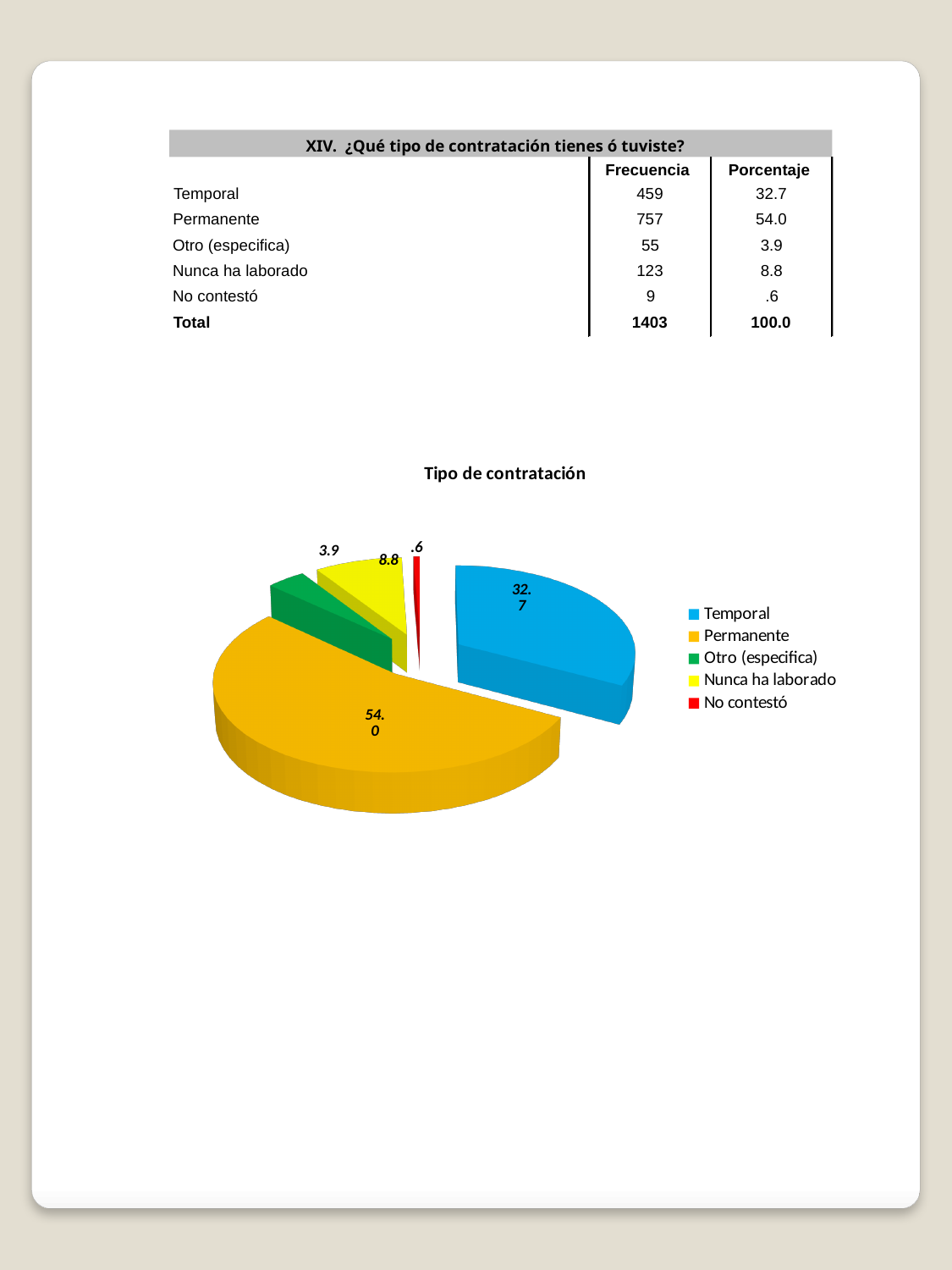
What value is shown for the No contestó slice? .6 What type of chart is shown on the slide? pie chart Which category has the smallest slice? No contestó What value is shown for the Temporal slice? 32.7 What value is shown for the Nunca ha laborado slice? 8.8 What is the title of the chart? Tipo de contratación What value is shown for the Permanente slice? 54.0 What value is shown for the Otro (especifica) slice? 3.9 Which colour represents Nunca ha laborado in the legend? yellow How many slices does the pie chart have? 5 What is the difference between the Permanente and Temporal values? 21.3 Which category has the largest slice? Permanente